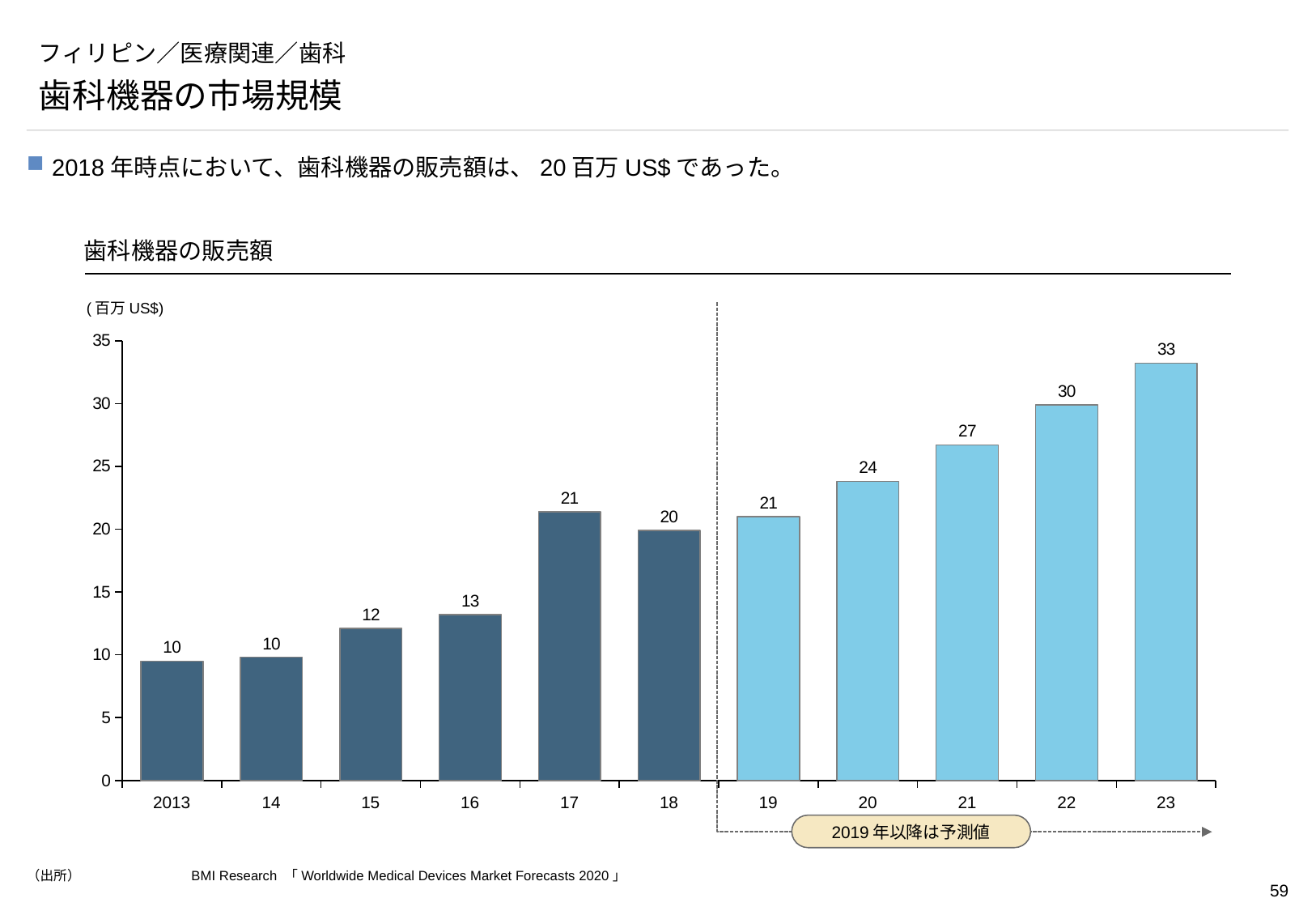
What is the difference between the values for 2023 and 2013? 23 Do the values generally rise or fall from 2018 to 2023? rise What is the value for 2018? 20 Is the value for 2022 greater or less than 25? greater What is the difference between the values for 2017 and 2016? 8 What is the value for 2023? 33 Which year has the highest value? 2023 How many years are shown on the x axis? 11 Which is larger, the value for 2017 or the value for 2018? 2017 What is the unit shown for the y axis? 百万 US$ What is the value for 2015? 12 What kind of chart is shown? bar chart